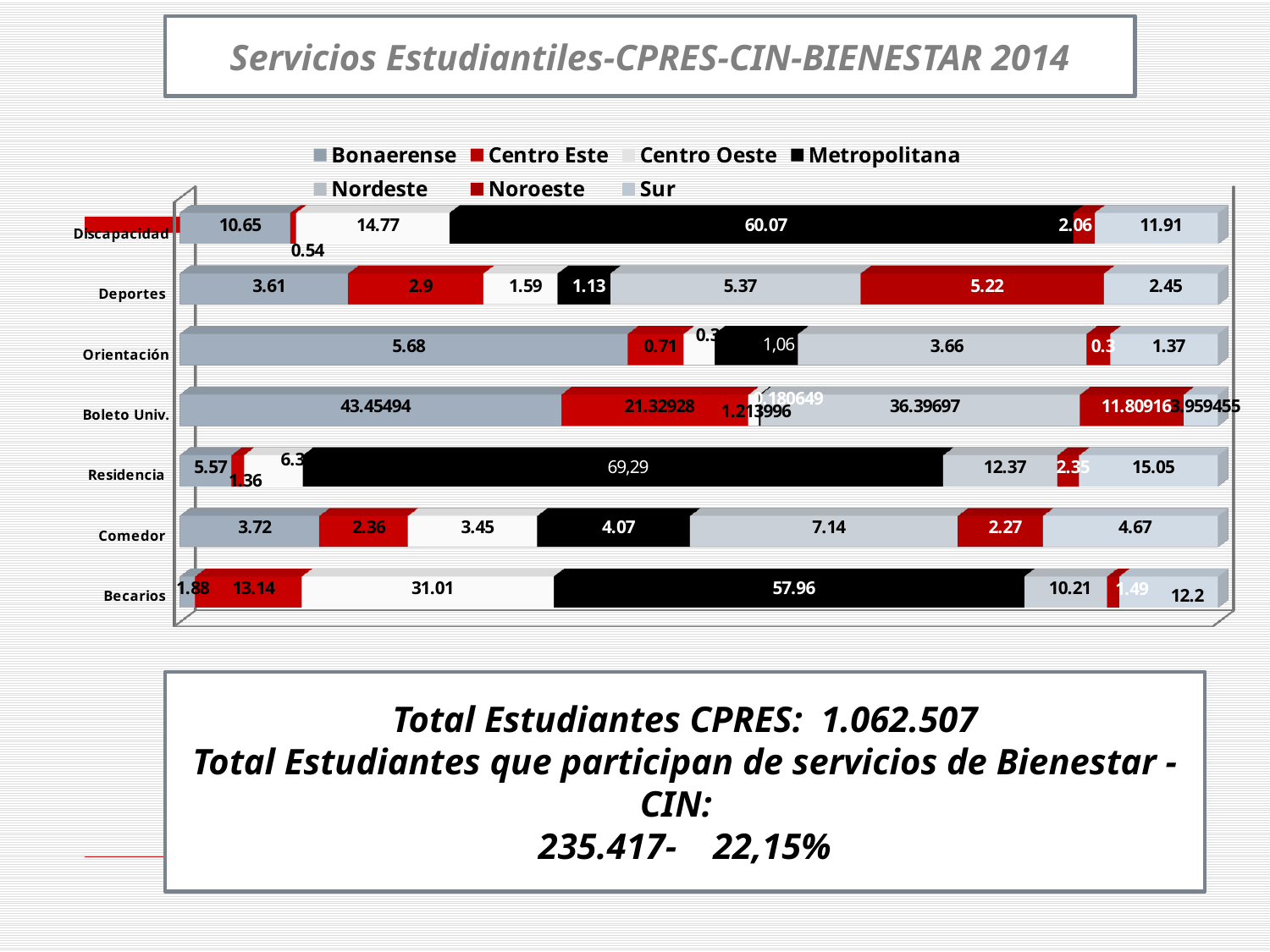
How many service categories are plotted on the chart? 7 What is the Noroeste value for Deportes? 5.22 What is the Sur value for Residencia? 15.05 How many series does the legend list? 7 Which region has the largest segment in the Boleto Univ. bar? Bonaerense What is the Metropolitana value for Discapacidad? 60.07 What is the Centro Oeste value for Becarios? 31.01 What is the difference between the Metropolitana value for Discapacidad and the Metropolitana value for Becarios? 2.11 What kind of chart is shown on the slide? Stacked bar chart In the Comedor bar, which is larger: the Nordeste value or the Sur value? Nordeste Which region has the largest segment in the Becarios bar? Metropolitana What is the Nordeste value for Boleto Univ.? 36.39697